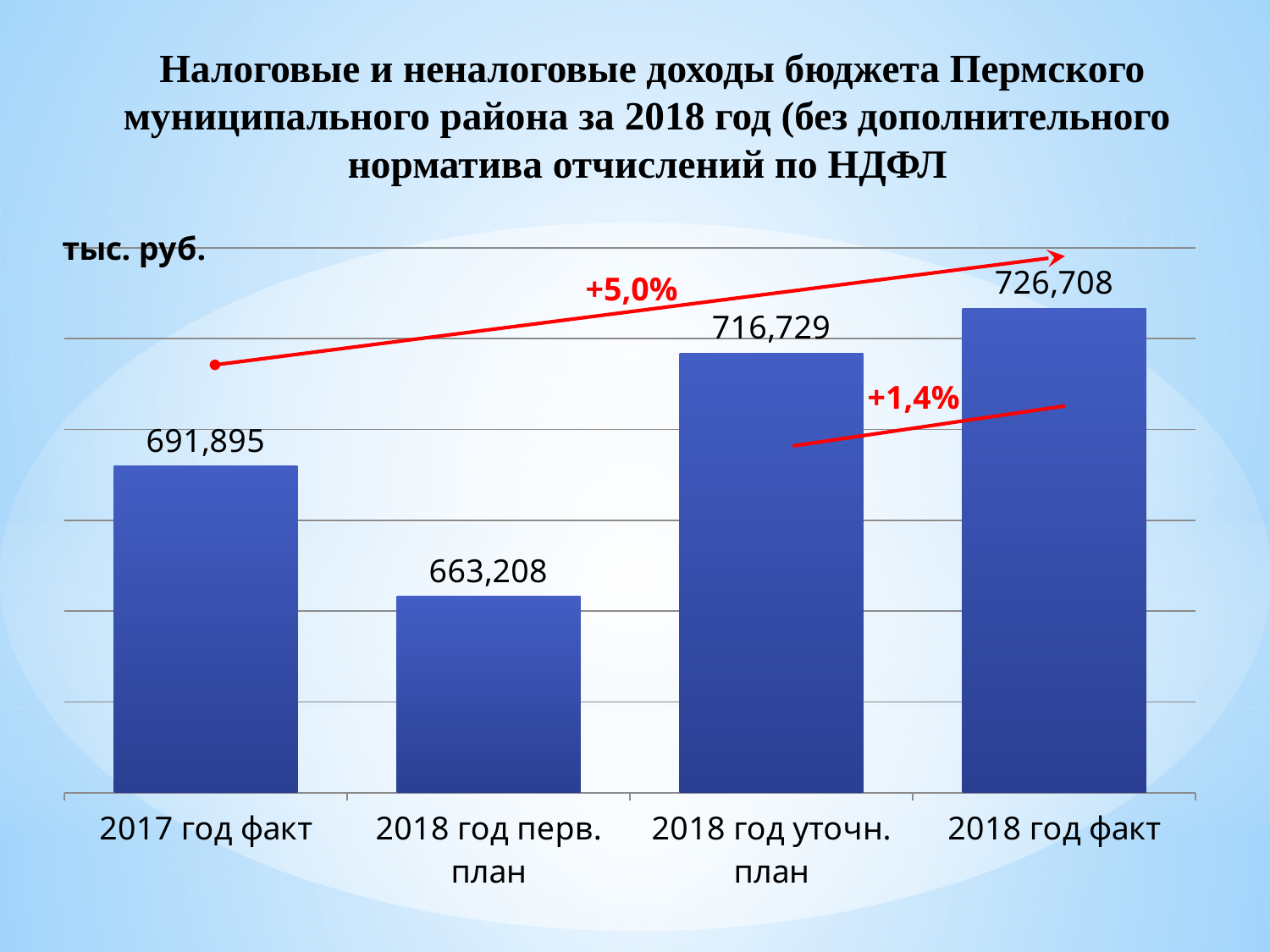
What is the value for 2018 год перв. план? 663,208 Which category has the highest value? 2018 год факт What is the value for 2018 год факт? 726,708 Which category has the lowest value? 2018 год перв. план What is the value for 2018 год уточн. план? 716,729 What kind of chart is shown on the slide? Bar chart What is the value for 2017 год факт? 691,895 How many bars are shown in the chart? 4 What is the difference between the values for 2018 год уточн. план and 2018 год перв. план? 53,521 Which is larger, the value for 2017 год факт or the value for 2018 год перв. план? 2017 год факт What is the difference between the values for 2018 год факт and 2017 год факт? 34,813 What unit of measurement is indicated above the chart? тыс. руб.